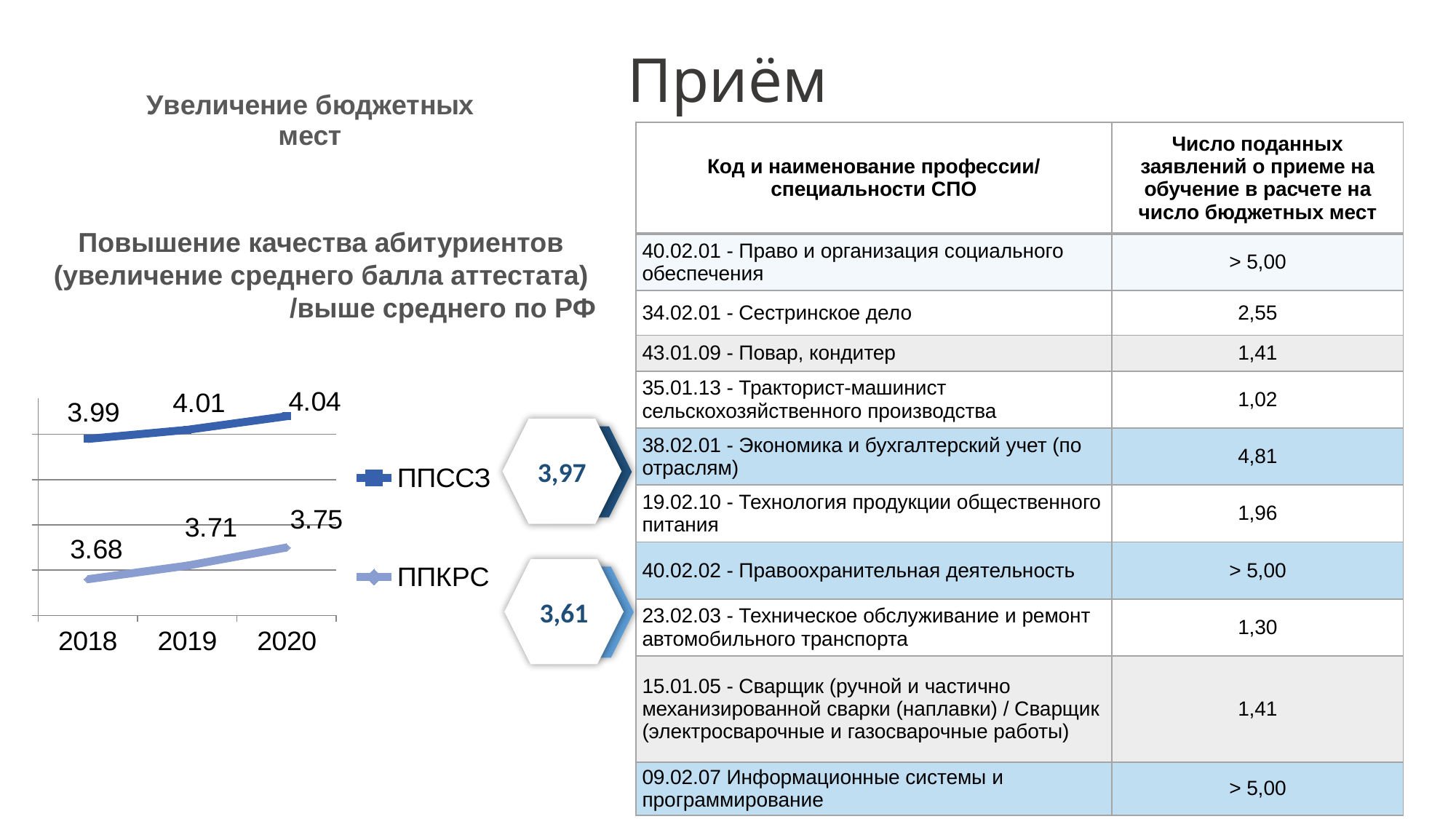
In which year is the ППССЗ value highest on the line chart? 2020 Do the ППКРС values rise or fall from 2018 to 2020 on the line chart? rise What kind of chart is shown on the left of the slide? line chart How many series does the legend of the line chart list? 2 How many years are shown on the x axis of the line chart? 3 What is the value for ППКРС in 2019 on the line chart? 3.71 What is the value for ППКРС in 2020 on the line chart? 3.75 What is the difference between the ППССЗ and ППКРС values in 2020 on the line chart? 0.29 In which year is the ППКРС value lowest on the line chart? 2018 What is the value for ППССЗ in 2020 on the line chart? 4.04 What is the value for ППССЗ in 2018 on the line chart? 3.99 Which series are listed in the legend of the line chart? ППССЗ and ППКРС